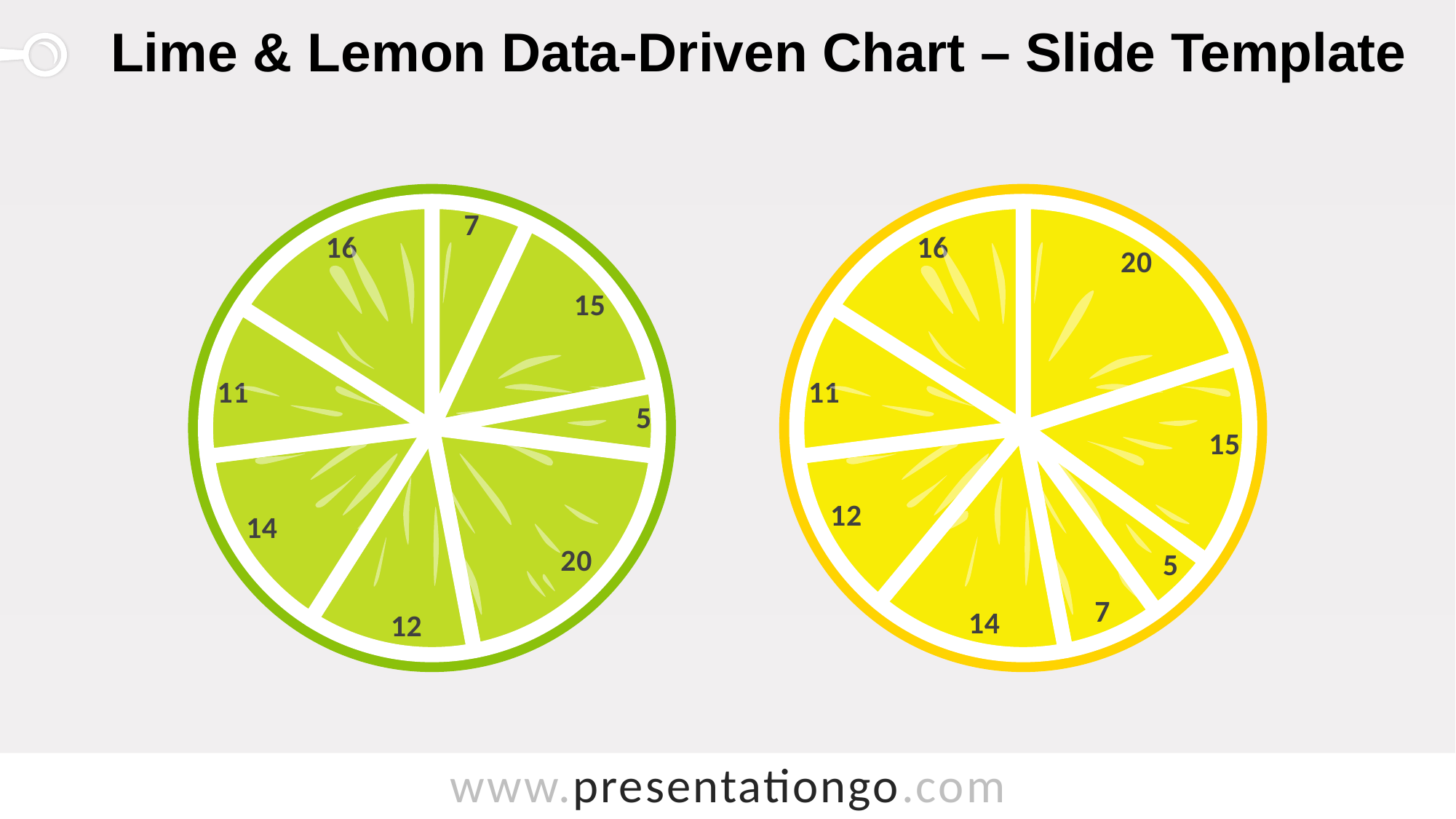
In the lime chart on the left, what is the smallest slice value? 5 What is the title of the slide containing the two charts? Lime & Lemon Data-Driven Chart – Slide Template How many slices does the lime chart on the left have? 8 In the lemon chart on the right, what is the smallest slice value? 5 How many slices does the lemon chart on the right have? 8 In the lemon chart on the right, what is the largest slice value? 20 In the lemon chart on the right, what share of the total does the slice labeled 20 represent? 20% In the lime chart on the left, what is the total of all slice values? 100 In the lime chart on the left, what is the difference between the largest slice (20) and the smallest slice (5)? 15 In the lemon chart on the right, what is the total of all slice values? 100 What kind of chart is the lime chart on the left? pie chart In the lime chart on the left, what is the largest slice value? 20